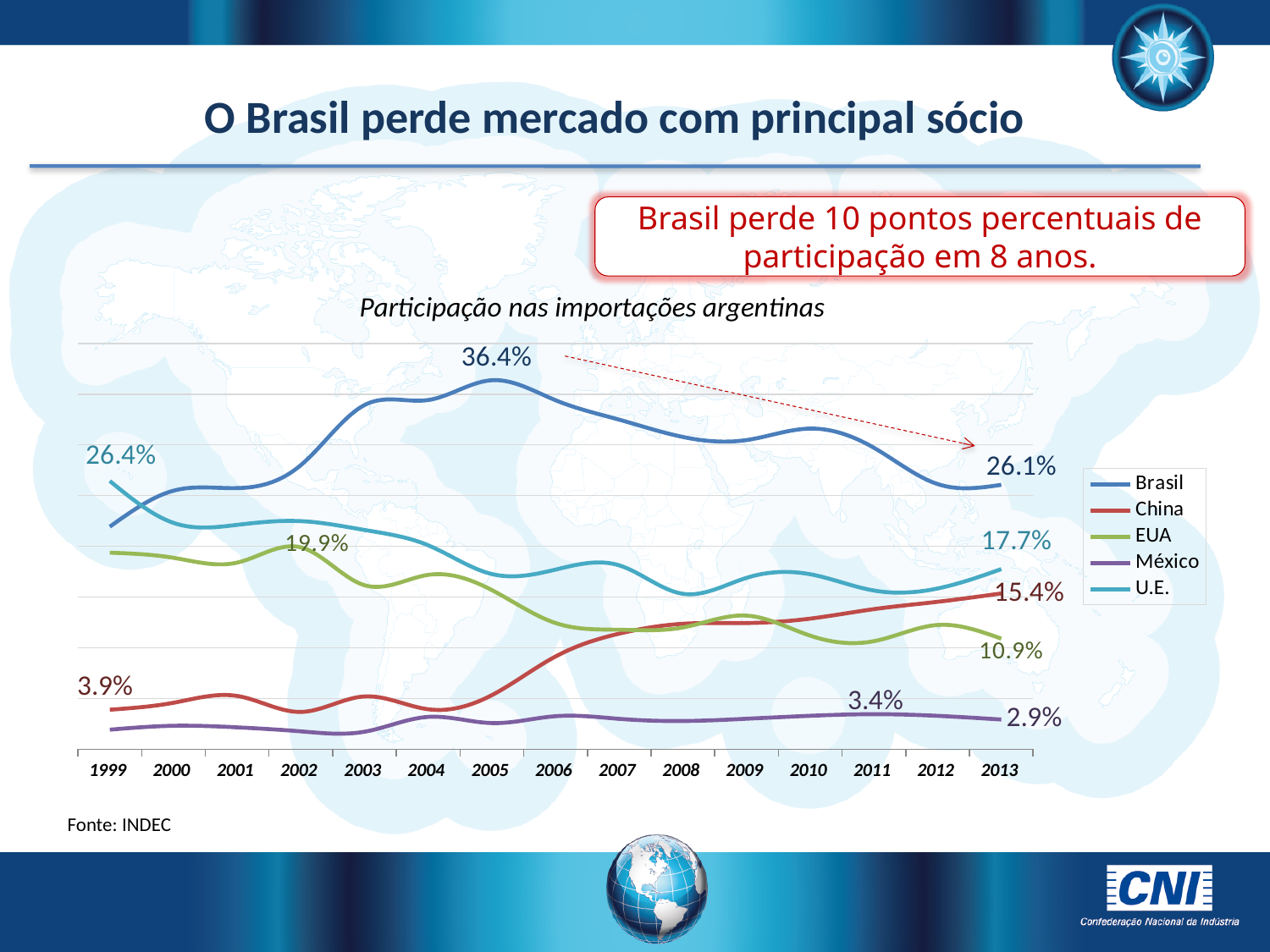
What is the value for México in 2013? 2.9% Does the China line rise or fall from 1999 to 2013? Rise What kind of chart is shown on the slide? Line chart Which series has the lowest value in 2013? México What is the value for U.E. in 2013? 17.7% How many years are shown on the x axis? 15 What is the peak value labelled on the Brasil line in 2005? 36.4% How many series does the legend list? 5 What is the value for EUA in 2013? 10.9% By how many percentage points did Brasil's share fall from its 2005 peak to 2013? 10.3 percentage points What is the value for China in 2013? 15.4% What is the value for Brasil in 2013? 26.1%